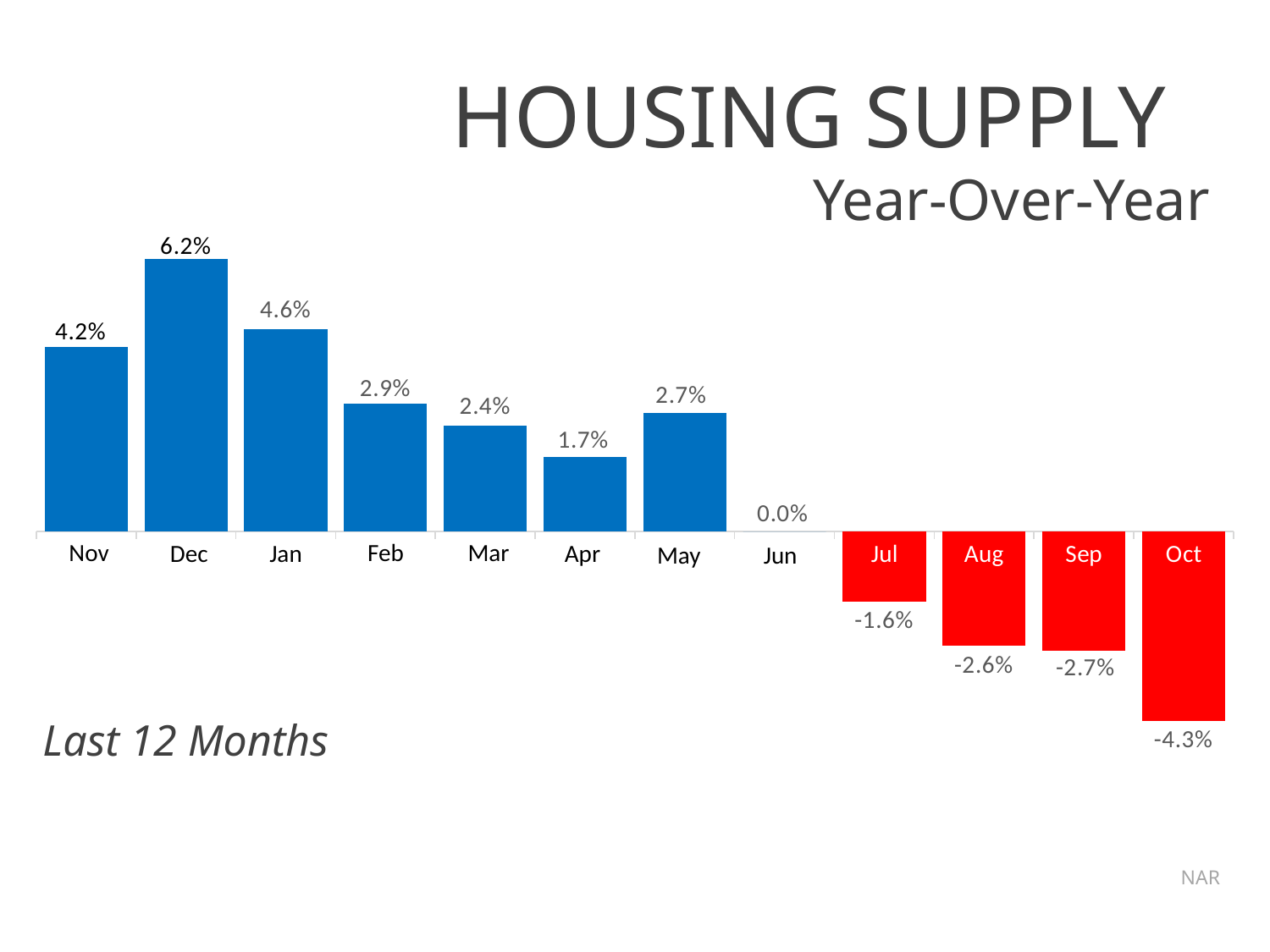
How many months are plotted on the chart? 12 Which month has the highest year-over-year value? Dec What is the year-over-year housing supply value for Dec? 6.2% What is the difference between the values for Jan and Feb? 1.7% What kind of chart is shown on the slide? Bar chart Do the values generally rise or fall from Dec to Oct along the x axis? Fall Which month has the lowest year-over-year value? Oct What is the value shown for Oct? -4.3% What is the value shown for Jun? 0.0% What colour are the bars for the months with negative values? Red What is the difference between the values for Dec and Nov? 2.0% Which is larger, the value for Mar or the value for May? May